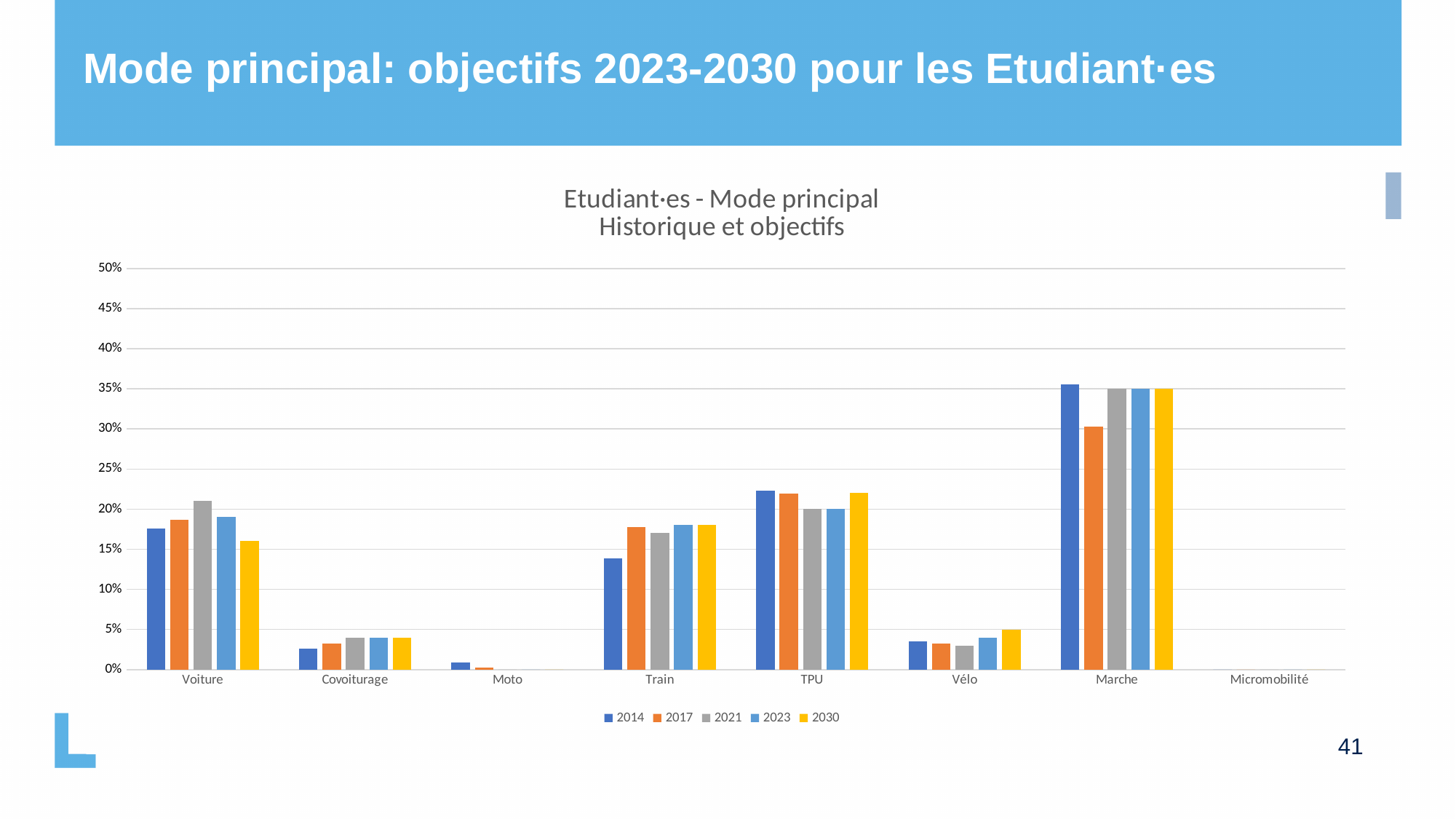
Is the value for Voiture in 2030 greater or less than 20%? less How many series does the legend list? 5 What kind of chart is shown on the slide? bar chart Which is larger in 2014: the value for Train or the value for TPU? TPU Is the value for Marche in 2014 greater or less than 30%? greater Which is larger for Voiture: the 2021 value or the 2030 value? 2021 Which category has the highest value for the 2014 series? Marche Is the value for Covoiturage in 2030 greater or less than 5%? less Which category has the highest value for the 2030 series? Marche How many categories are shown on the x axis of the chart? 8 What is the title of the chart? Etudiant·es - Mode principal Historique et objectifs